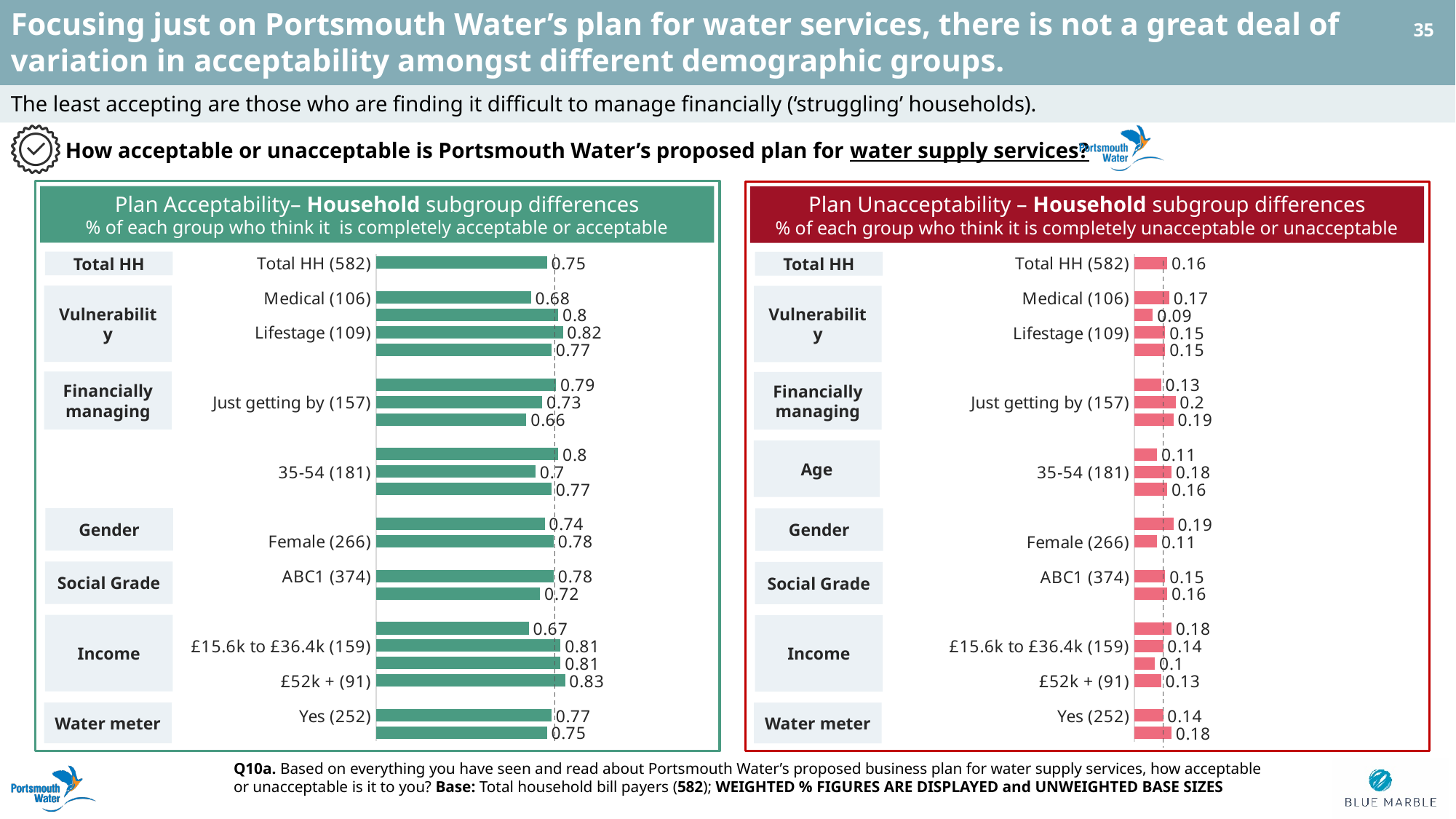
In the Plan Unacceptability chart, what is the difference between the values for 35-54 (181) and Yes (252)? 0.04 What kind of chart is the Plan Acceptability chart? Bar chart In the Plan Acceptability chart, which labelled group has the highest value? £52k + (91) In the Plan Unacceptability chart, what is the value for Just getting by (157)? 0.2 In the Plan Acceptability chart, which is larger: the value for Female (266) or the value for 35-54 (181)? Female (266) In the Plan Acceptability chart, what is the difference between the values for Lifestage (109) and Medical (106)? 0.14 In the Plan Unacceptability chart, what is the value for Female (266)? 0.11 What colour are the bars in the Plan Unacceptability chart? Red In the Plan Unacceptability chart, which group has the highest value? Just getting by (157) In the Plan Acceptability chart, what is the value for Total HH (582)? 0.75 In the Plan Acceptability chart, what is the value for £52k + (91)? 0.83 In the Plan Unacceptability chart, which is larger: the value for Medical (106) or the value for £52k + (91)? Medical (106)